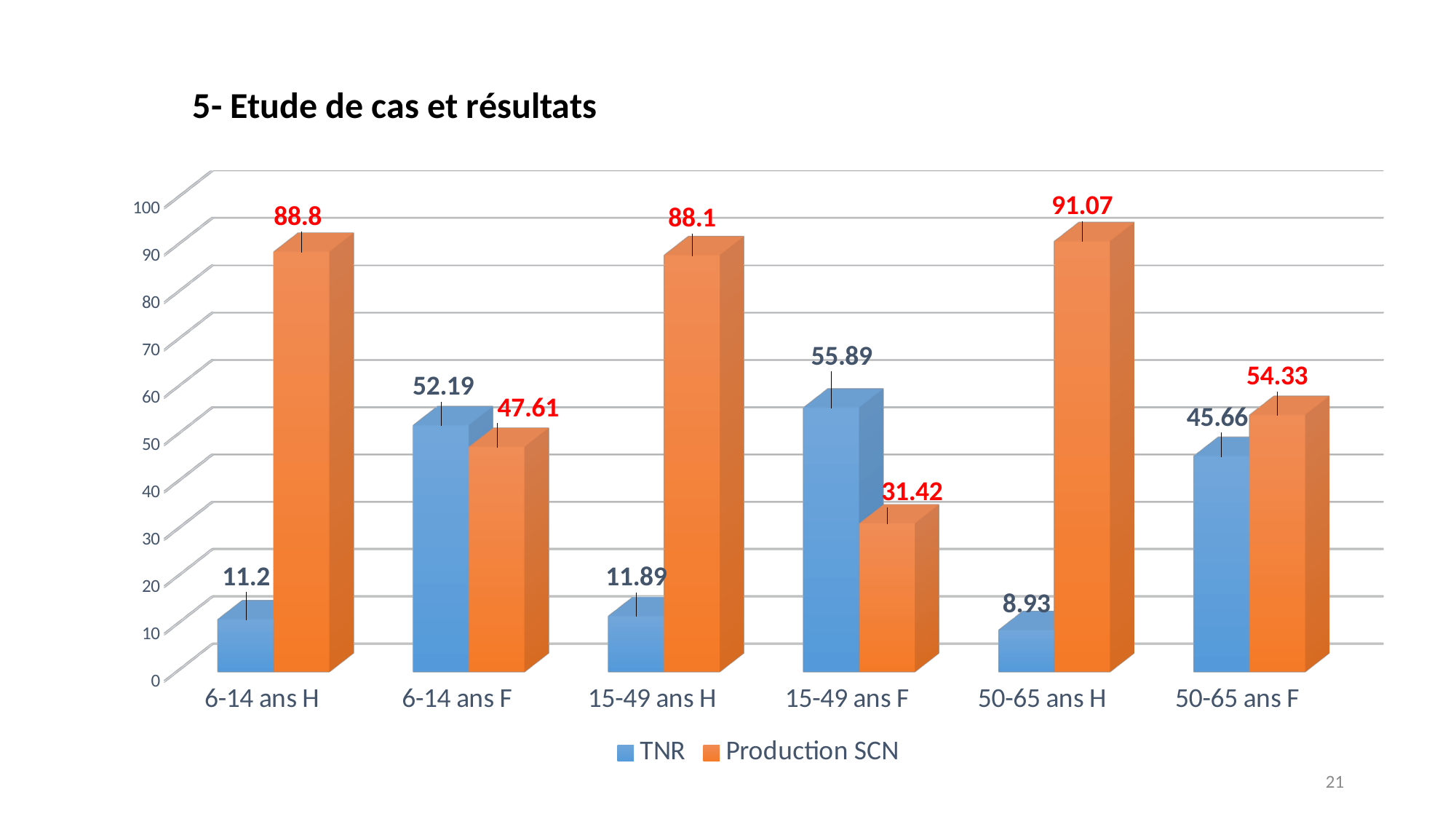
What is the difference between the Production SCN and TNR values for 6-14 ans H? 77.6 Which category has the lowest TNR value? 50-65 ans H What is the Production SCN value for 15-49 ans F? 31.42 How many categories are shown on the x axis? 6 How many series does the legend list? 2 What is the TNR value for 15-49 ans F? 55.89 What is the TNR value for 6-14 ans H? 11.2 What kind of chart is shown on the slide? Bar chart What is the Production SCN value for 50-65 ans H? 91.07 Which is larger for 6-14 ans F, the TNR value or the Production SCN value? TNR Which colour represents the Production SCN series? Orange Which category has the highest Production SCN value? 50-65 ans H